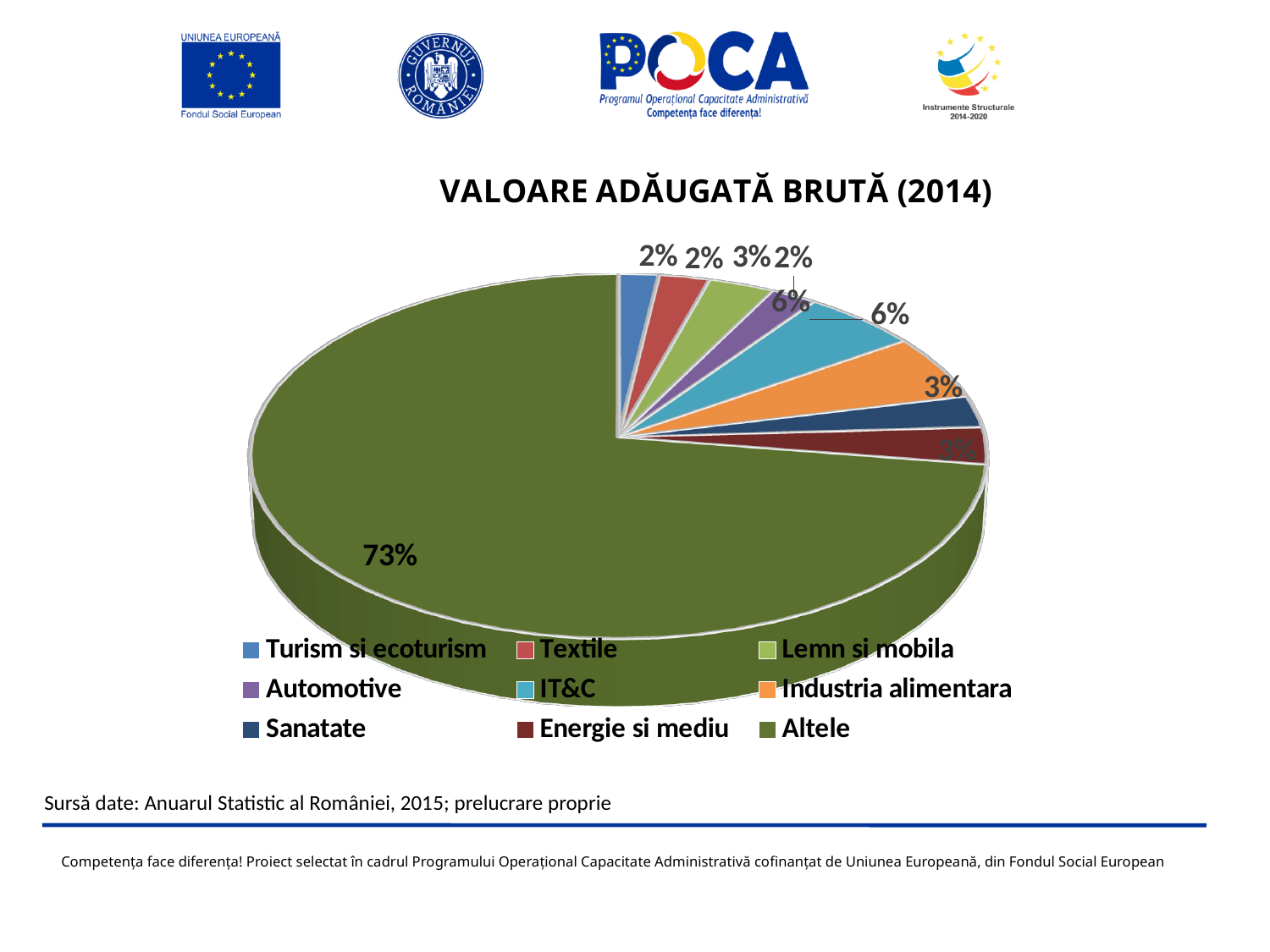
What is the title of the chart? VALOARE ADĂUGATĂ BRUTĂ (2014) What share of the pie does Altele account for? 73% What kind of chart is shown on the slide? Pie chart Which is larger, the slice for IT&C or the slice for Sanatate? IT&C Which category has the largest slice of the pie? Altele What is the value shown for IT&C? 6% How many categories does the pie chart show? 9 What is the value shown for Industria alimentara? 6% What is the difference in percentage points between Altele and IT&C? 67 percentage points What is the value shown for Turism si ecoturism? 2% What is the value shown for Lemn si mobila? 3% What is the value shown for Sanatate? 3%